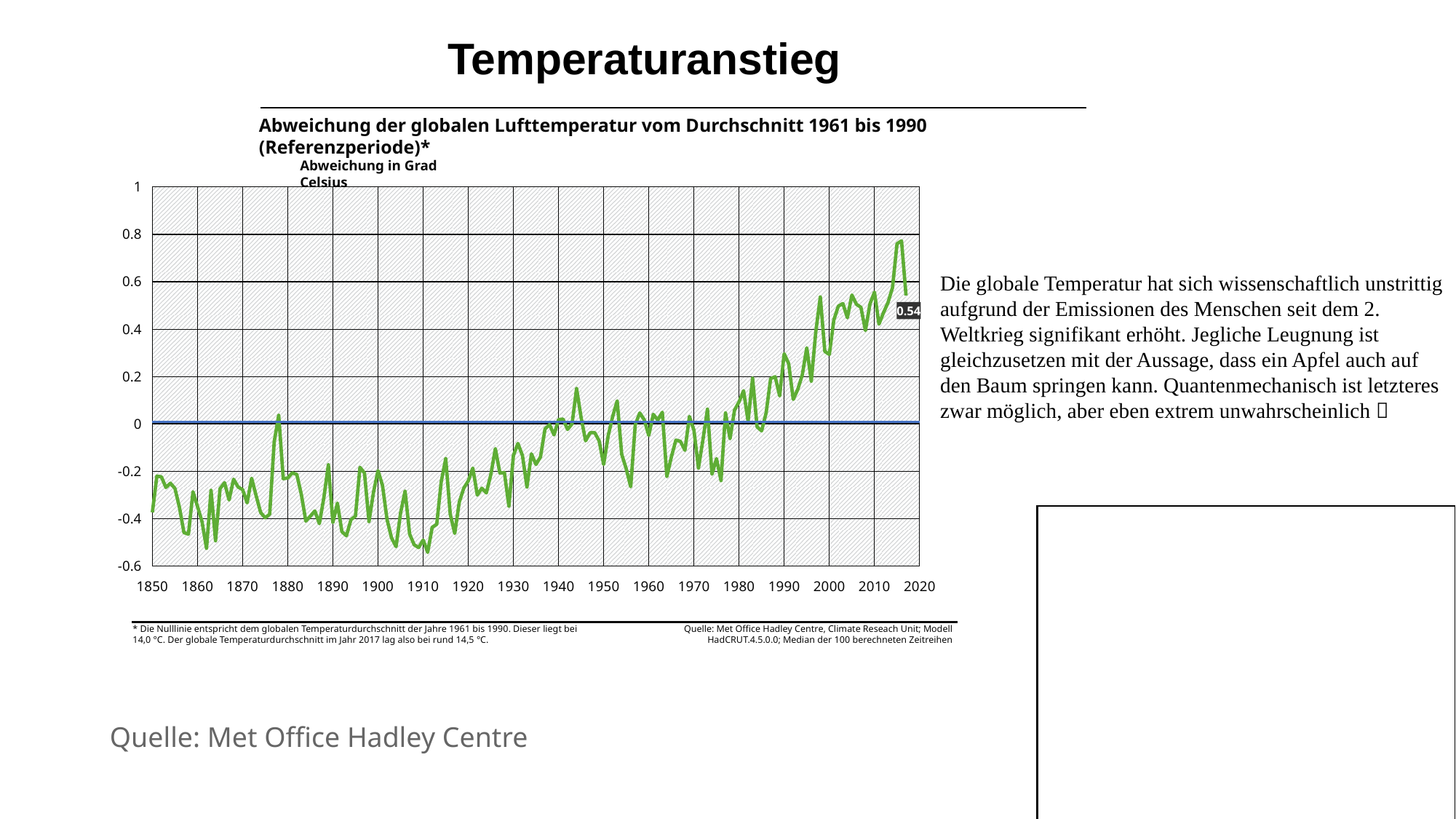
Is the highest value of the line greater or less than 0.6? greater How many year labels are shown on the x axis? 18 Does the line reach its highest point before or after 2010? after What value is printed as the data label at the end of the line? 0.54 What is the label of the y axis? Abweichung in Grad Celsius Is the value of the line around 2000 greater or less than 0.2? greater Is the value of the line around 1910 greater or less than -0.4? less What kind of chart is shown on the slide? line chart Overall, does the temperature deviation rise or fall from 1850 to 2020? rise Does the line reach its lowest point before or after 1950? before Is the value of the line around 1990 larger or smaller than the value around 1900? larger